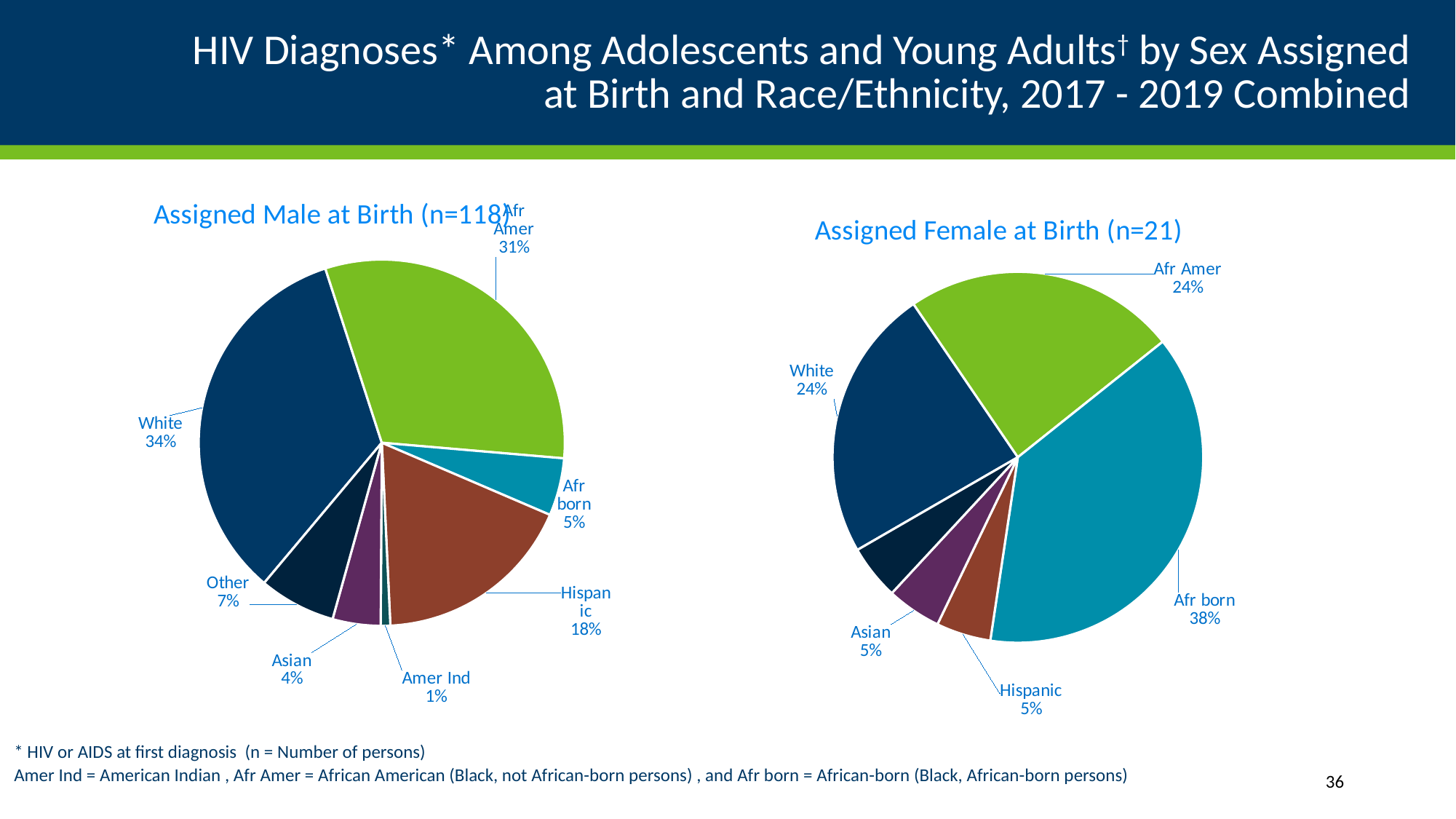
In the Assigned Female at Birth chart, what share of diagnoses is Afr born? 38% In the Assigned Female at Birth chart, what is the difference between the Afr born and White shares? 14% How many slices does the Assigned Male at Birth pie chart have? 7 Which is larger in the Assigned Male at Birth chart: the Hispanic share or the Other share? Hispanic What type of chart is used on this slide? Pie chart In the Assigned Female at Birth chart, what share of diagnoses is Afr Amer? 24% In the Assigned Male at Birth chart, what share of diagnoses is Hispanic? 18% In the Assigned Male at Birth chart, which race/ethnicity has the smallest share? Amer Ind In the Assigned Male at Birth chart, what is the difference between the White and Afr Amer shares? 3% In the Assigned Female at Birth chart, which race/ethnicity has the largest share? Afr born In the Assigned Male at Birth chart, which race/ethnicity has the largest share? White In the Assigned Male at Birth chart, what share of diagnoses is White? 34%